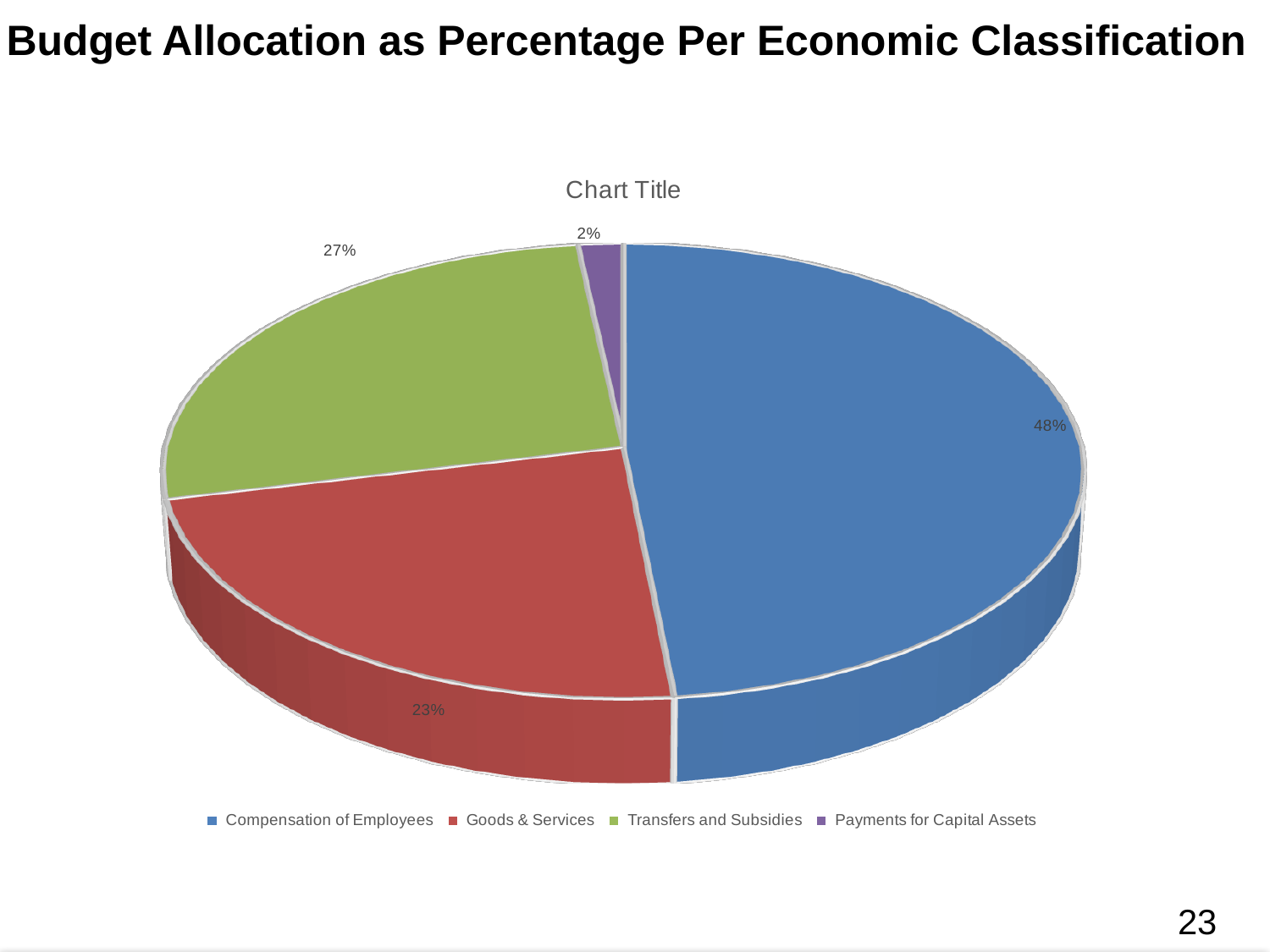
What percentage of the budget is allocated to Compensation of Employees? 48% What is the combined percentage for Goods & Services and Payments for Capital Assets? 25% How many slices does the pie chart have? 4 What is the difference in percentage points between Compensation of Employees and Transfers and Subsidies? 21 Which economic classification receives the smallest share of the budget? Payments for Capital Assets Which economic classification receives the largest share of the budget? Compensation of Employees What percentage of the budget is allocated to Payments for Capital Assets? 2% What type of chart is shown on the slide? Pie chart What percentage of the budget is allocated to Transfers and Subsidies? 27% What colour is the slice for Transfers and Subsidies? Green What percentage of the budget is allocated to Goods & Services? 23% Which is larger: the share for Goods & Services or the share for Transfers and Subsidies? Transfers and Subsidies